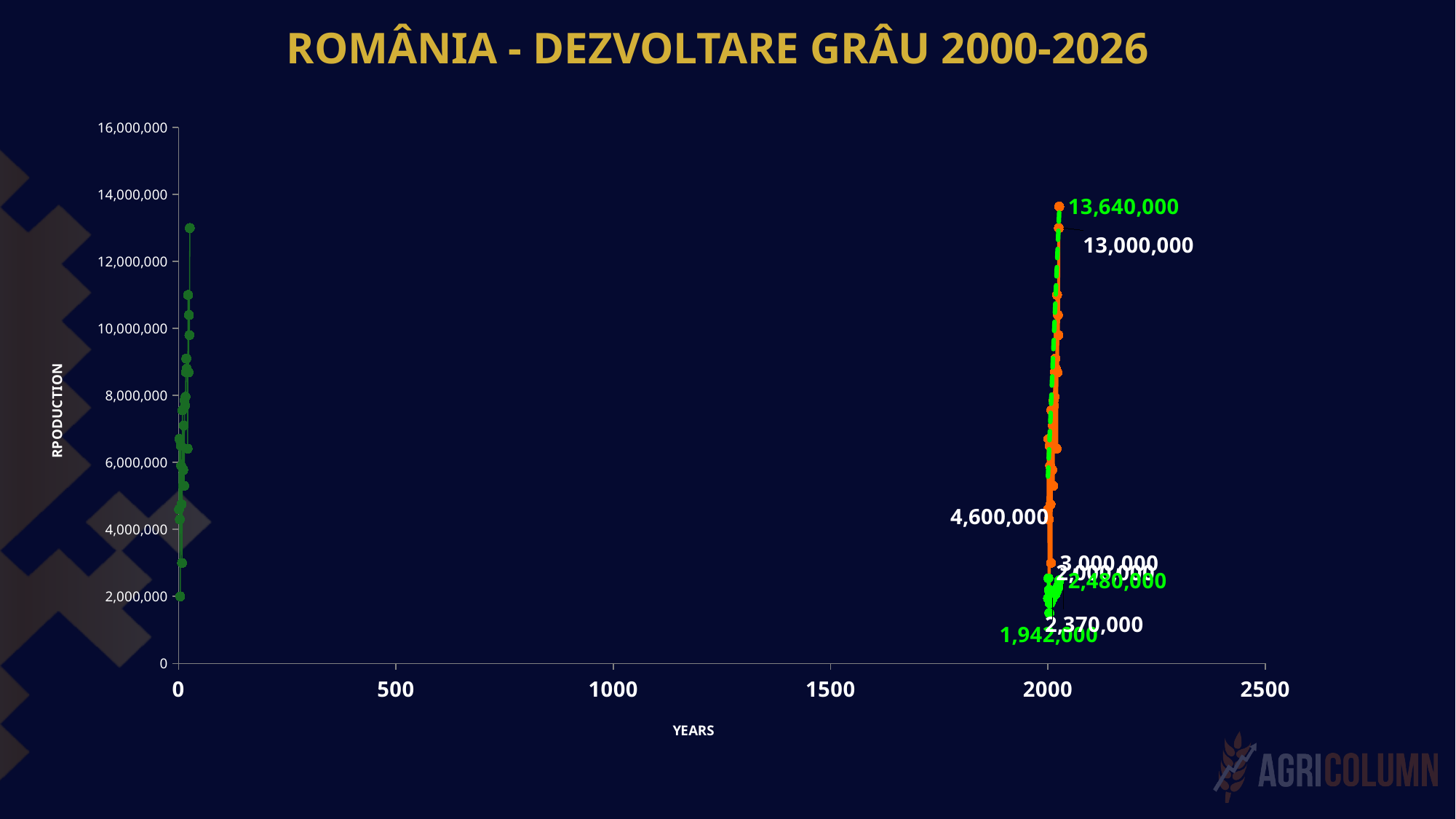
What is the title of the chart? ROMÂNIA - DEZVOLTARE GRÂU 2000-2026 Is the highest labelled value on the chart greater or less than 12,000,000? greater What is the difference between the labelled values 2,480,000 and 2,370,000? 110,000 What is the label of the horizontal axis? YEARS What is the highest value printed as a data label on the chart? 13,640,000 What is the maximum value shown on the vertical axis? 16,000,000 Which labelled value is larger, 4,600,000 or 3,000,000? 4,600,000 What is the lowest value printed as a data label on the chart? 1,942,000 What is the difference between the labelled values 13,640,000 and 13,000,000? 640,000 Is the labelled value 4,600,000 greater or less than 6,000,000? less